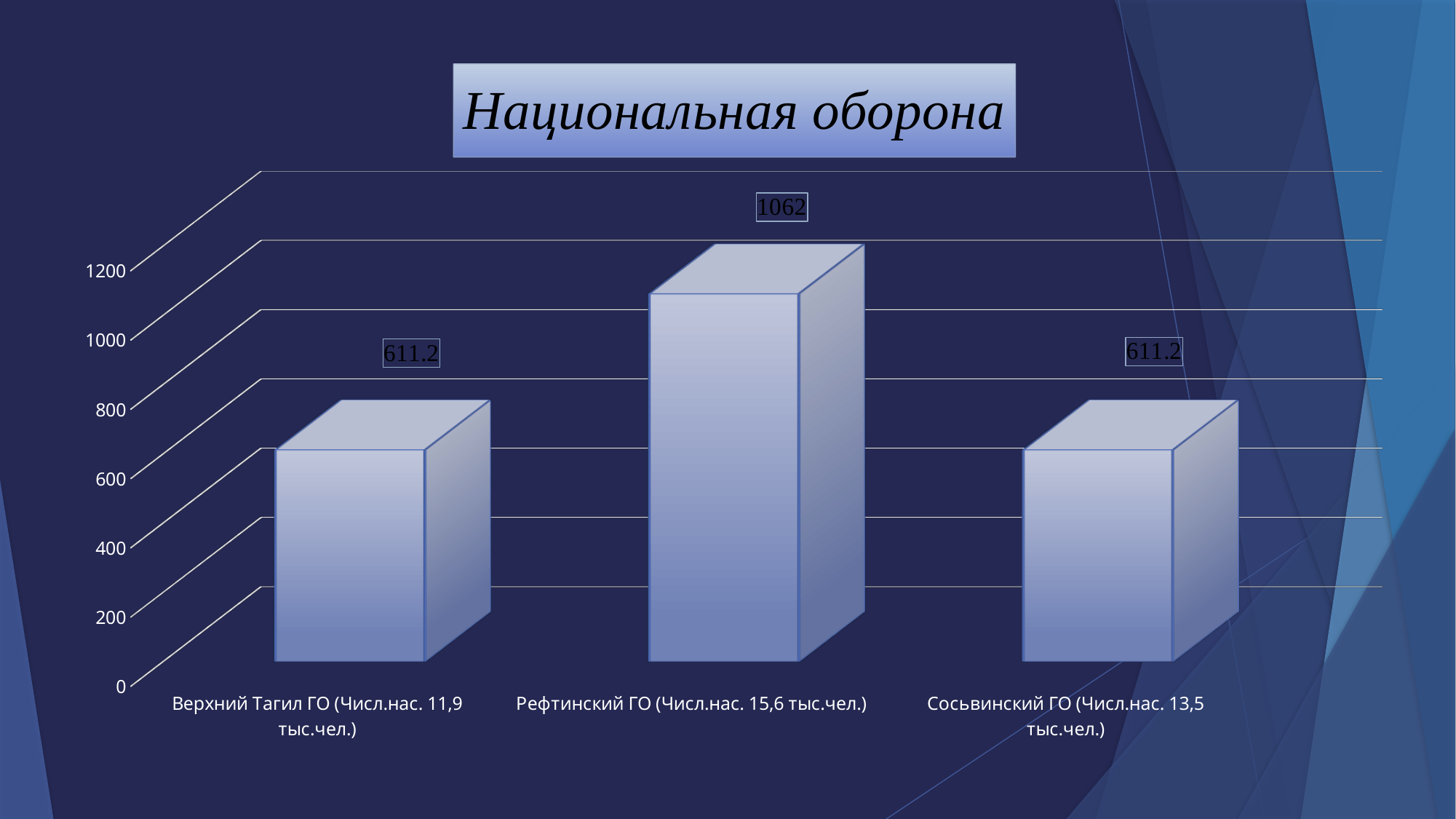
What is the difference between the values for Рефтинский ГО and Верхний Тагил ГО? 450.8 Which is larger, the value for Рефтинский ГО or the value for Сосьвинский ГО? Рефтинский ГО Is the value for Рефтинский ГО greater or less than 1000? greater What is the highest value labelled on the vertical axis? 1200 What is the title of the slide? Национальная оборона What is the value for Верхний Тагил ГО? 611.2 What kind of chart is shown on the slide? bar chart How many categories are shown on the chart? 3 Which category has the highest value? Рефтинский ГО What is the value for Рефтинский ГО? 1062 What is the value for Сосьвинский ГО? 611.2 Is the value for Верхний Тагил ГО greater or less than 800? less